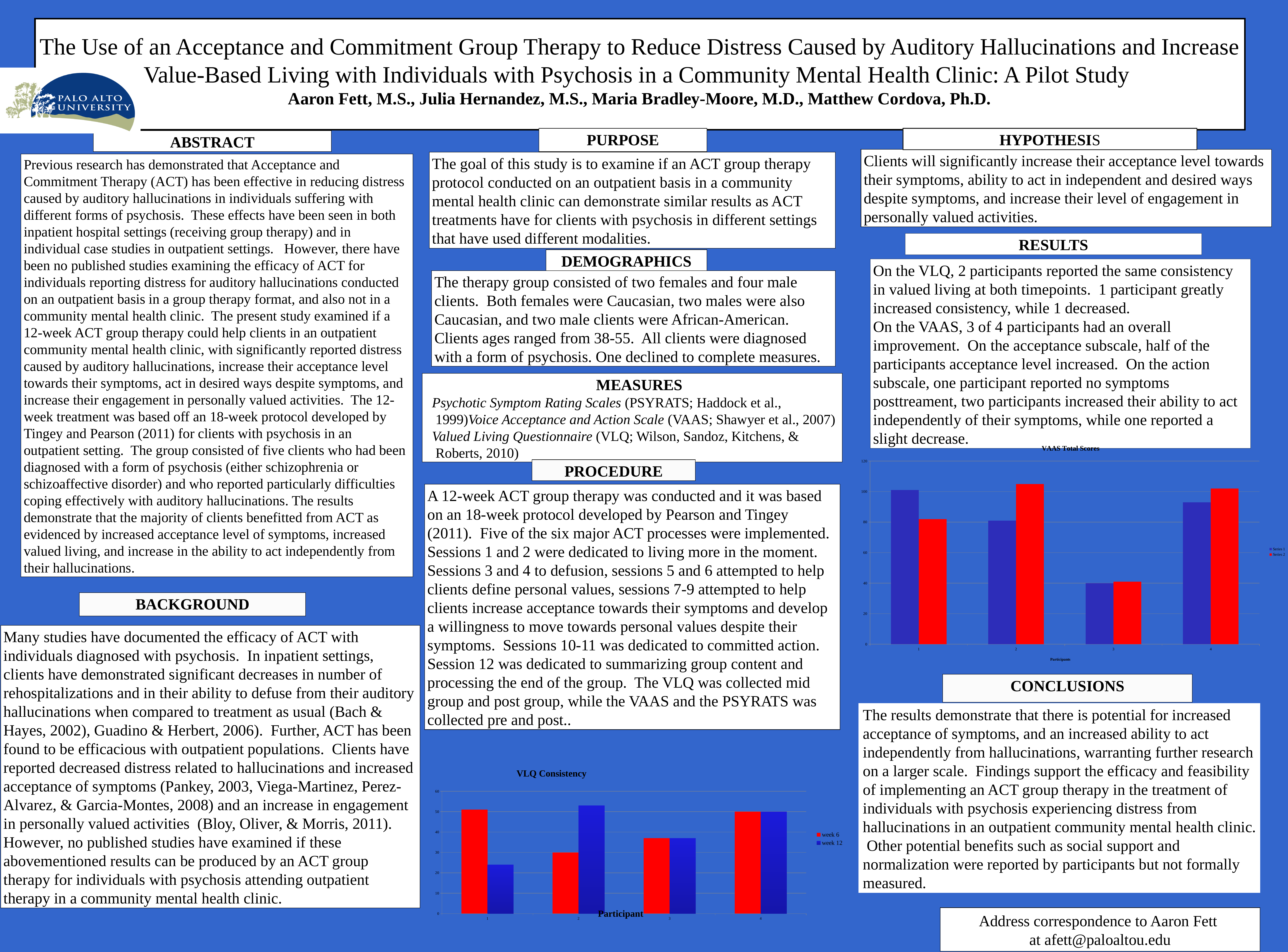
What type of chart is the 'VLQ Consistency' chart? bar chart In the 'VAAS Total Scores' chart, is the Series 2 value for participant 2 greater or less than 100? greater In the 'VAAS Total Scores' chart, for participant 1, which series has the larger value, Series 1 or Series 2? Series 1 How many participants are shown on the x axis of the 'VLQ Consistency' chart? 4 In the 'VAAS Total Scores' chart, which participant has the lowest Series 1 value? 3 How many series does the legend of the 'VAAS Total Scores' chart list? 2 In the 'VLQ Consistency' chart, is the week 12 value for participant 1 greater or less than 30? less In the 'VLQ Consistency' chart, for participant 2, which is larger, week 6 or week 12? week 12 In the 'VAAS Total Scores' chart, is the Series 1 value for participant 3 greater or less than 60? less What are the legend entries of the 'VLQ Consistency' chart? week 6, week 12 How many series does the legend of the 'VLQ Consistency' chart list? 2 What type of chart is the 'VAAS Total Scores' chart? bar chart